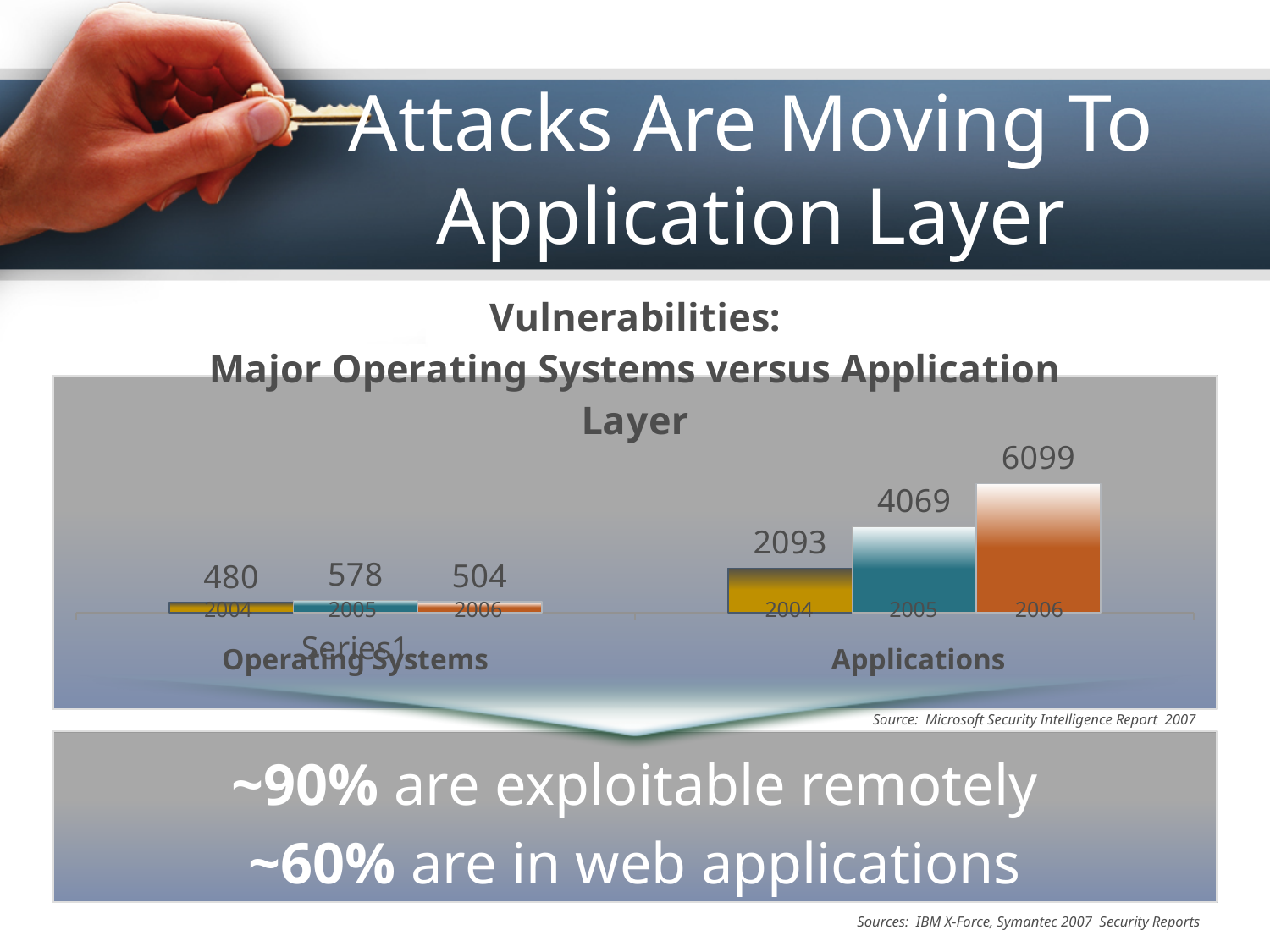
How many bars are plotted in the chart in total? 6 Which bar has the highest value in the chart? Applications 2006 What is the number of vulnerabilities for Applications in 2004? 2093 What kind of chart is shown on the slide? bar chart What is the difference between the Applications values for 2006 and 2005? 2030 Do the Applications values rise or fall from 2004 to 2006? rise What is the number of vulnerabilities for Applications in 2006? 6099 What is the difference between the Applications and Operating Systems values for 2004? 1613 What is the number of vulnerabilities for Operating Systems in 2005? 578 Which bar has the lowest value in the chart? Operating Systems 2004 Which is larger, the Operating Systems value for 2005 or for 2006? 2005 What is the number of vulnerabilities for Operating Systems in 2004? 480